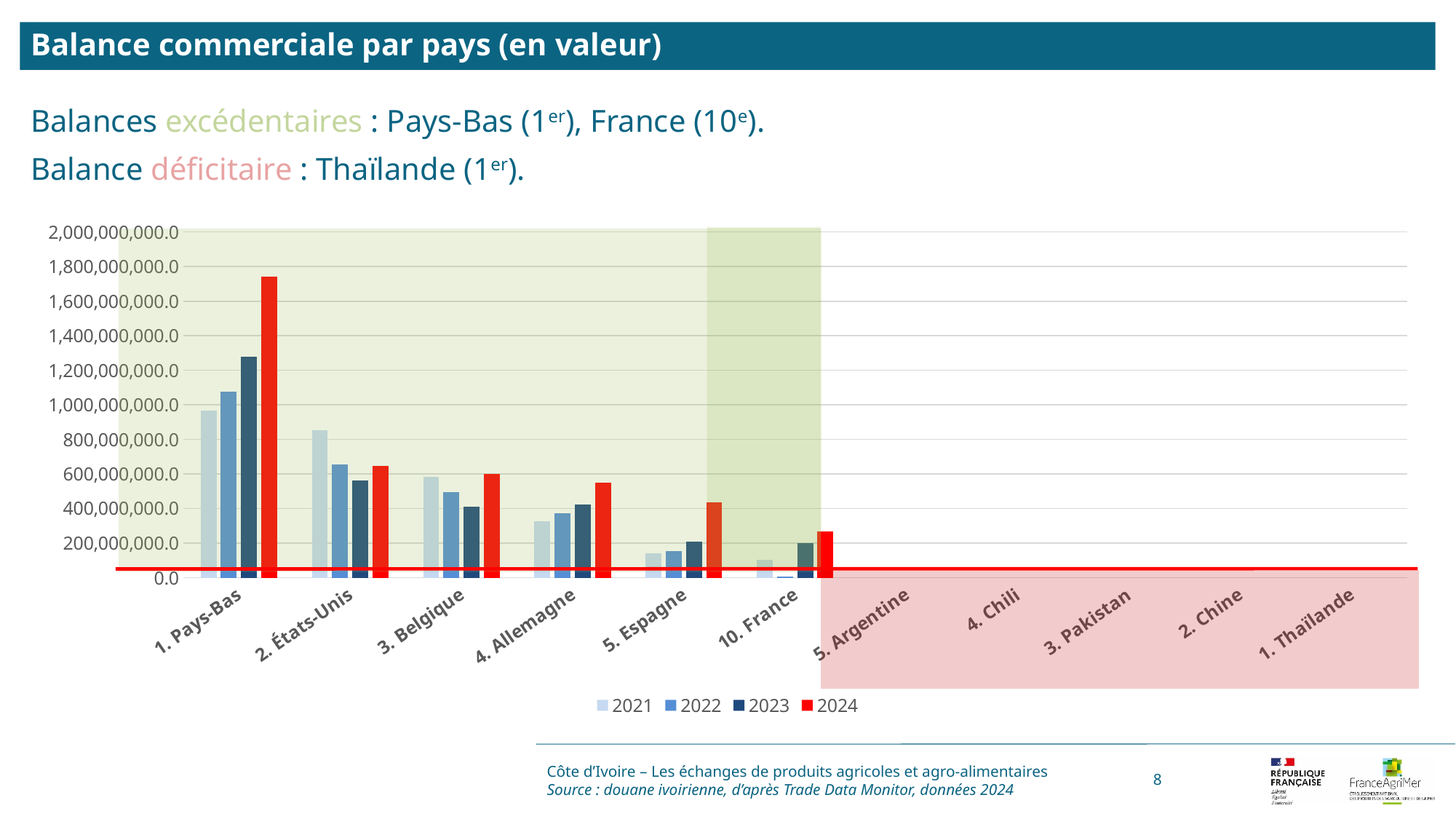
Is the 2024 value for 1. Pays-Bas greater or less than 1,600,000,000.0? greater Do the bars for 1. Pays-Bas rise or fall from 2021 to 2024? rise How many series does the legend list? 4 Which country has the highest 2024 bar? 1. Pays-Bas Is the 2024 value for 10. France greater or less than 200,000,000.0? greater Which years are listed in the legend? 2021, 2022, 2023, 2024 What kind of chart is shown on the slide? bar chart How many countries are shown on the x axis? 11 Which is larger, the 2023 value for 1. Pays-Bas or the 2023 value for 2. États-Unis? 1. Pays-Bas Which colour represents the 2024 series in the legend? red Is the 2024 value for 5. Espagne greater or less than 600,000,000.0? less